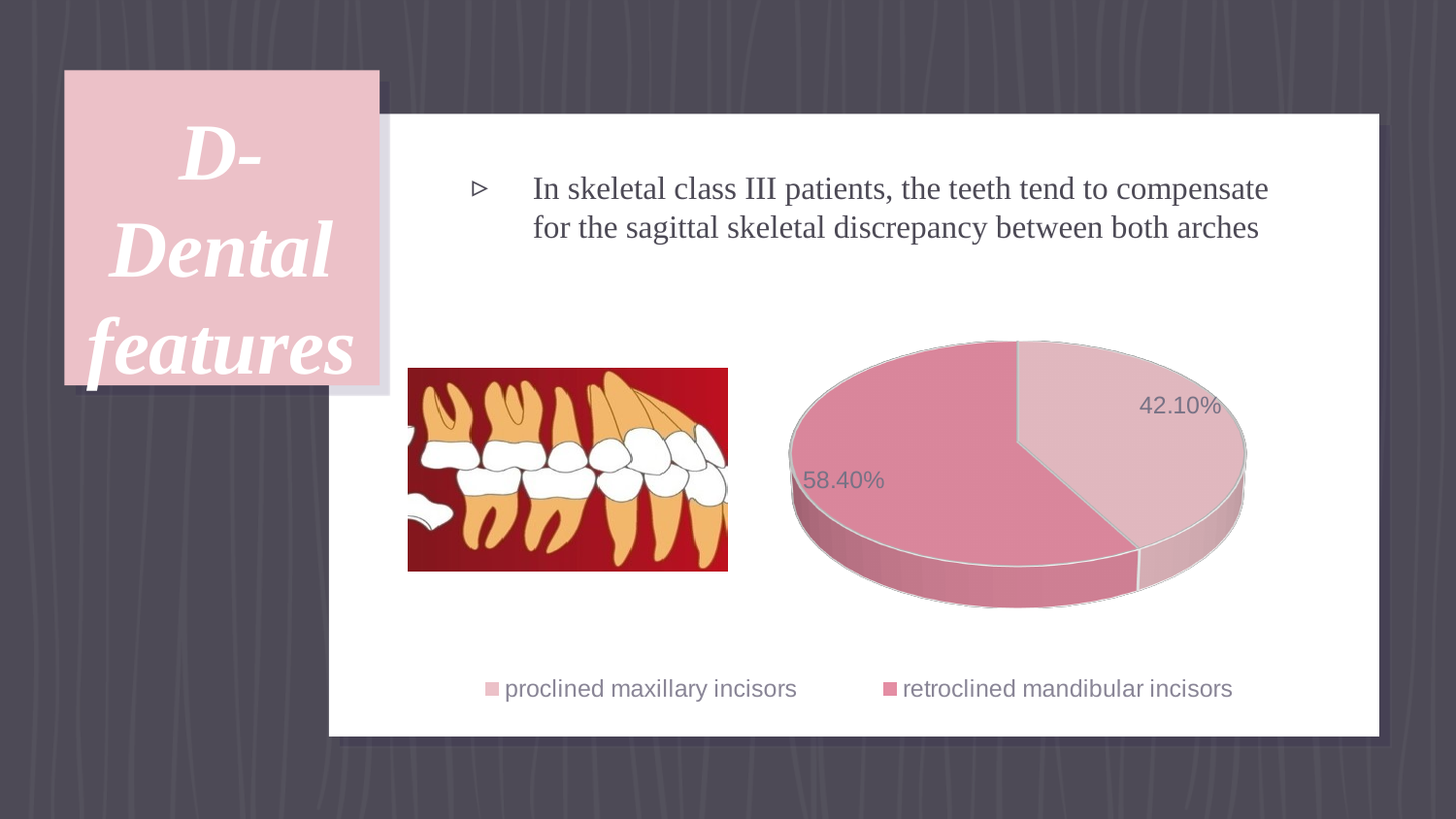
Which is larger: the slice for proclined maxillary incisors or the slice for retroclined mandibular incisors? retroclined mandibular incisors Which category has the smallest slice in the pie chart? proclined maxillary incisors Which category has the largest slice in the pie chart? retroclined mandibular incisors How many entries does the legend of the pie chart list? 2 What kind of chart is shown on the slide? pie chart How many slices does the pie chart have? 2 What is the value for retroclined mandibular incisors in the pie chart? 58.40% What is the difference between the retroclined mandibular incisors slice and the proclined maxillary incisors slice? 16.30% Where is the legend positioned relative to the pie chart? below the chart Which legend entry is shown in the darker pink colour in the pie chart? retroclined mandibular incisors What share of the pie does the proclined maxillary incisors slice represent? 42.10% What is the value for proclined maxillary incisors in the pie chart? 42.10%